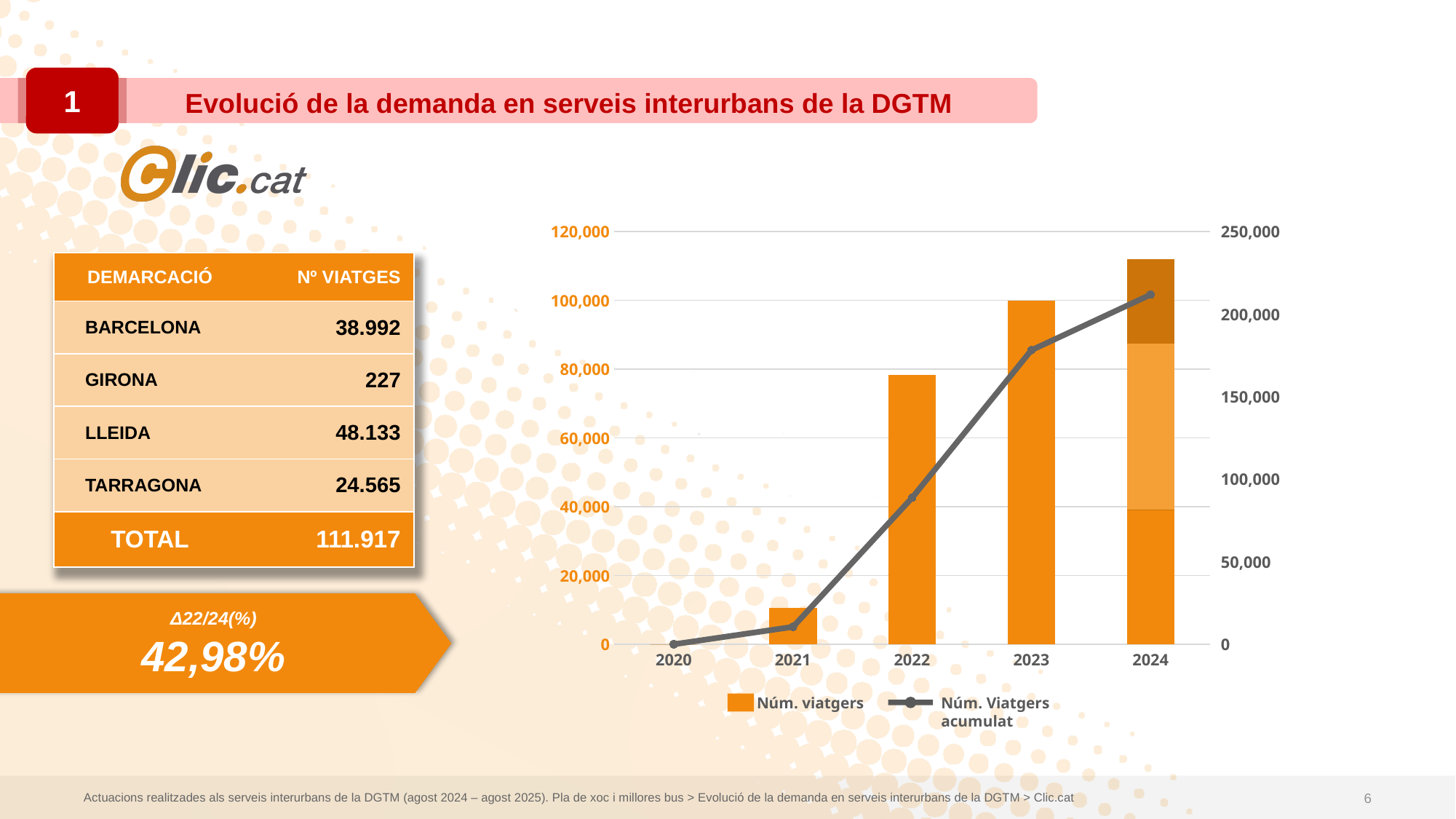
Which year has the tallest bar for Núm. viatgers? 2024 How many series does the chart legend list? 2 How many years are shown on the x axis of the chart? 5 What kind of chart is shown on the slide? A bar chart combined with a line Is the Núm. viatgers bar for 2022 greater or less than 60,000? greater Is the Núm. Viatgers acumulat value for 2023 greater or less than 200,000 on the right axis? less Which year has the lowest bar for Núm. viatgers? 2020 Is the Núm. Viatgers acumulat value for 2024 greater or less than 200,000 on the right axis? greater Do the Núm. viatgers bars rise or fall from 2020 to 2024? rise What are the two series named in the chart legend? Núm. viatgers and Núm. Viatgers acumulat Which year has a higher Núm. viatgers bar, 2022 or 2023? 2023